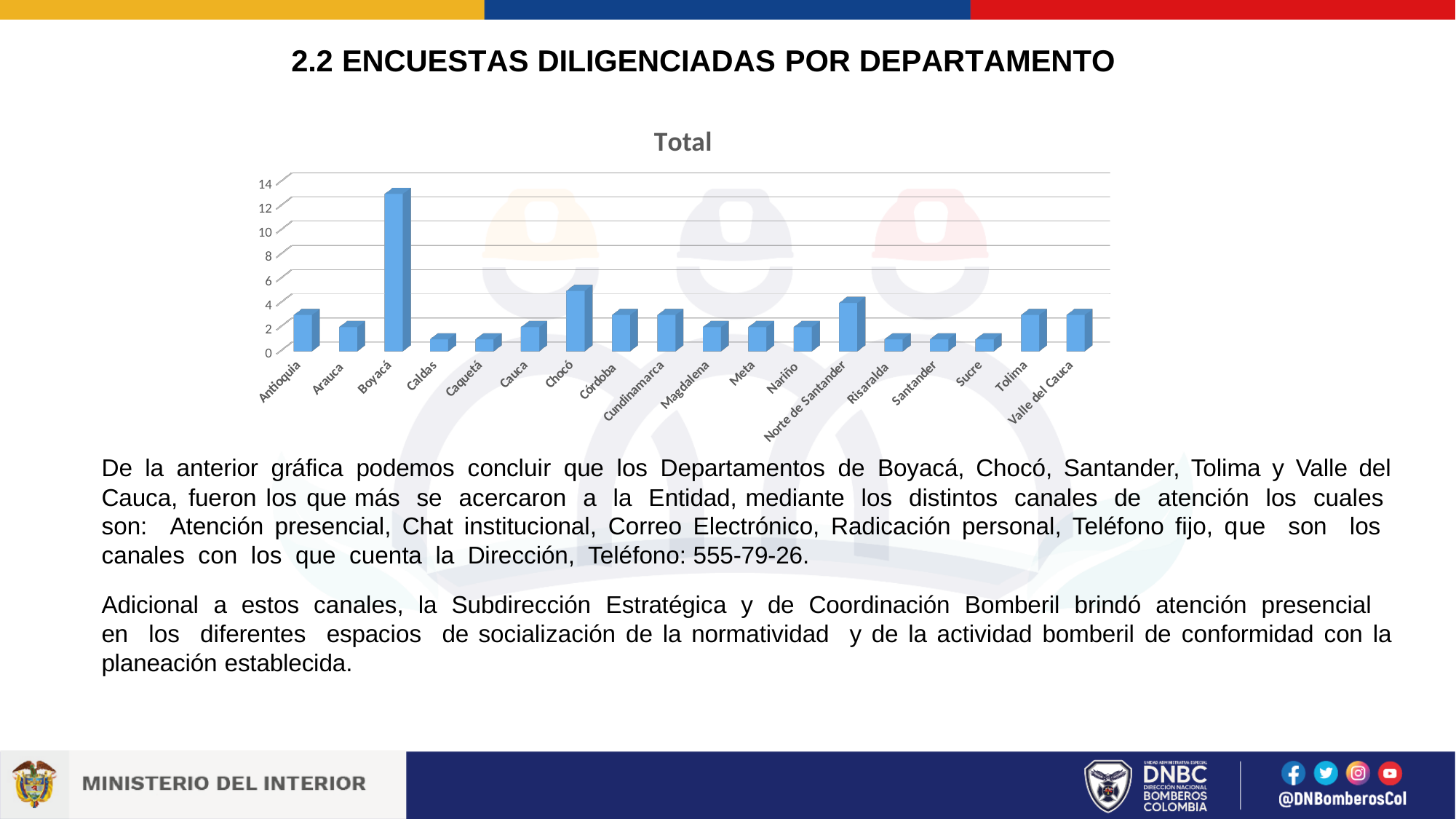
What is the highest value shown on the vertical axis of the chart? 14 Which has a larger value, Boyacá or Chocó? Boyacá What is the title of the chart? Total Is the value for Boyacá greater or less than 10? greater How many departments are shown on the x axis of the chart? 18 Which has a larger value, Norte de Santander or Risaralda? Norte de Santander What kind of chart is shown on the slide? bar chart Which has a larger value, Chocó or Caldas? Chocó Is the value for Norte de Santander greater or less than 2? greater Is the value for Caldas greater or less than 2? less Which department has the highest value in the chart? Boyacá